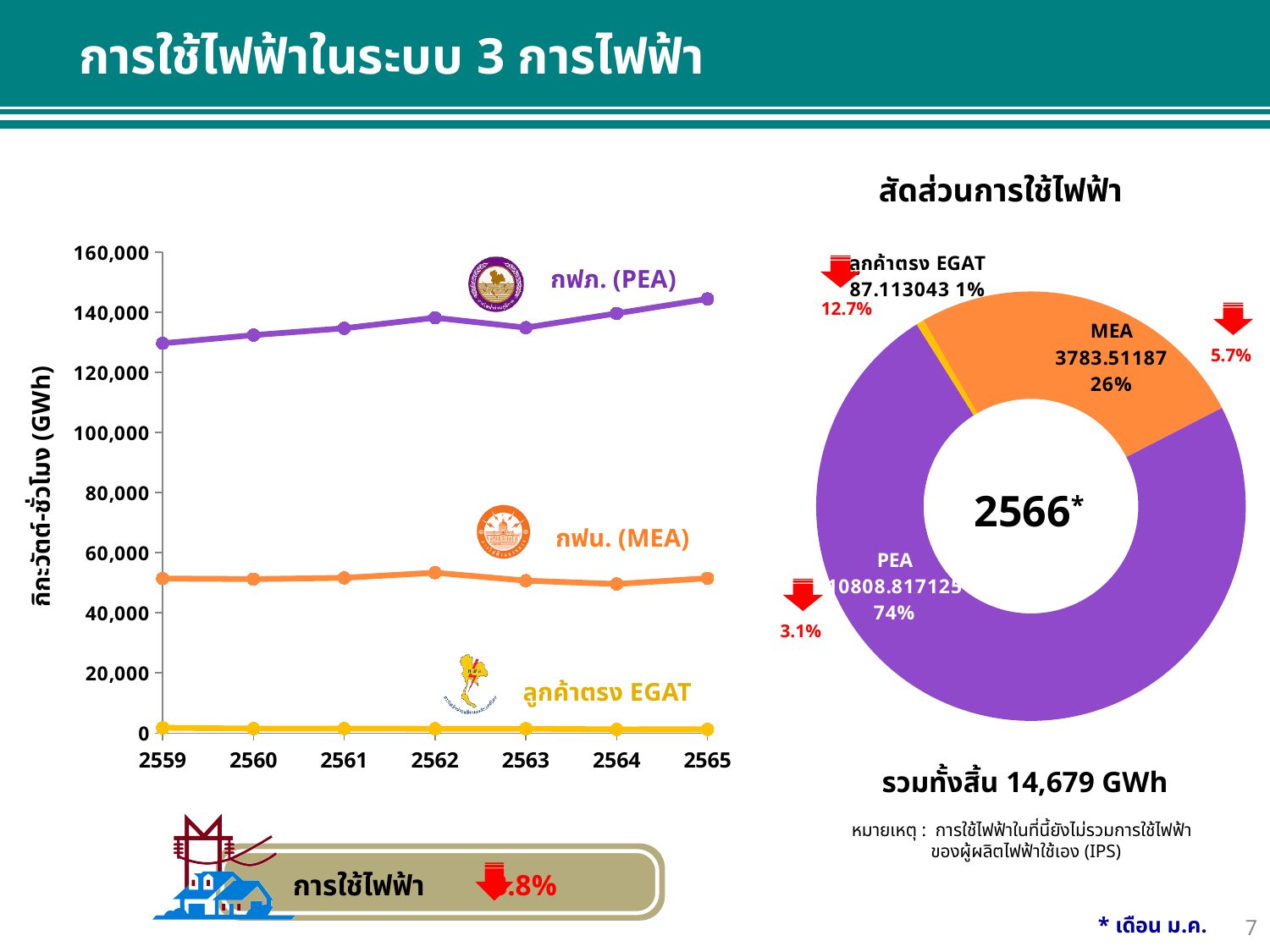
In the chart titled สัดส่วนการใช้ไฟฟ้า, what is the value shown for MEA? 3783.51187 In the chart titled สัดส่วนการใช้ไฟฟ้า, what share does PEA have? 74% In the line chart on the left, how many series are plotted? 3 In the line chart on the left, is the value for ลูกค้าตรง EGAT in 2559 greater or less than 20,000? less What kind of chart is the chart titled สัดส่วนการใช้ไฟฟ้า? doughnut chart In the line chart on the left, how many years are shown on the x axis? 7 In the line chart on the left, is the value for กฟน. (MEA) in 2562 greater or less than 60,000? less In the line chart on the left, is the value for กฟภ. (PEA) in 2565 greater or less than 140,000? greater In the chart titled สัดส่วนการใช้ไฟฟ้า, which segment is the smallest? ลูกค้าตรง EGAT In the line chart on the left, does the กฟภ. (PEA) line rise or fall overall from 2559 to 2565? rise What kind of chart is the chart on the left of the slide? line chart In the line chart on the left, which series has the highest values across all years? กฟภ. (PEA)